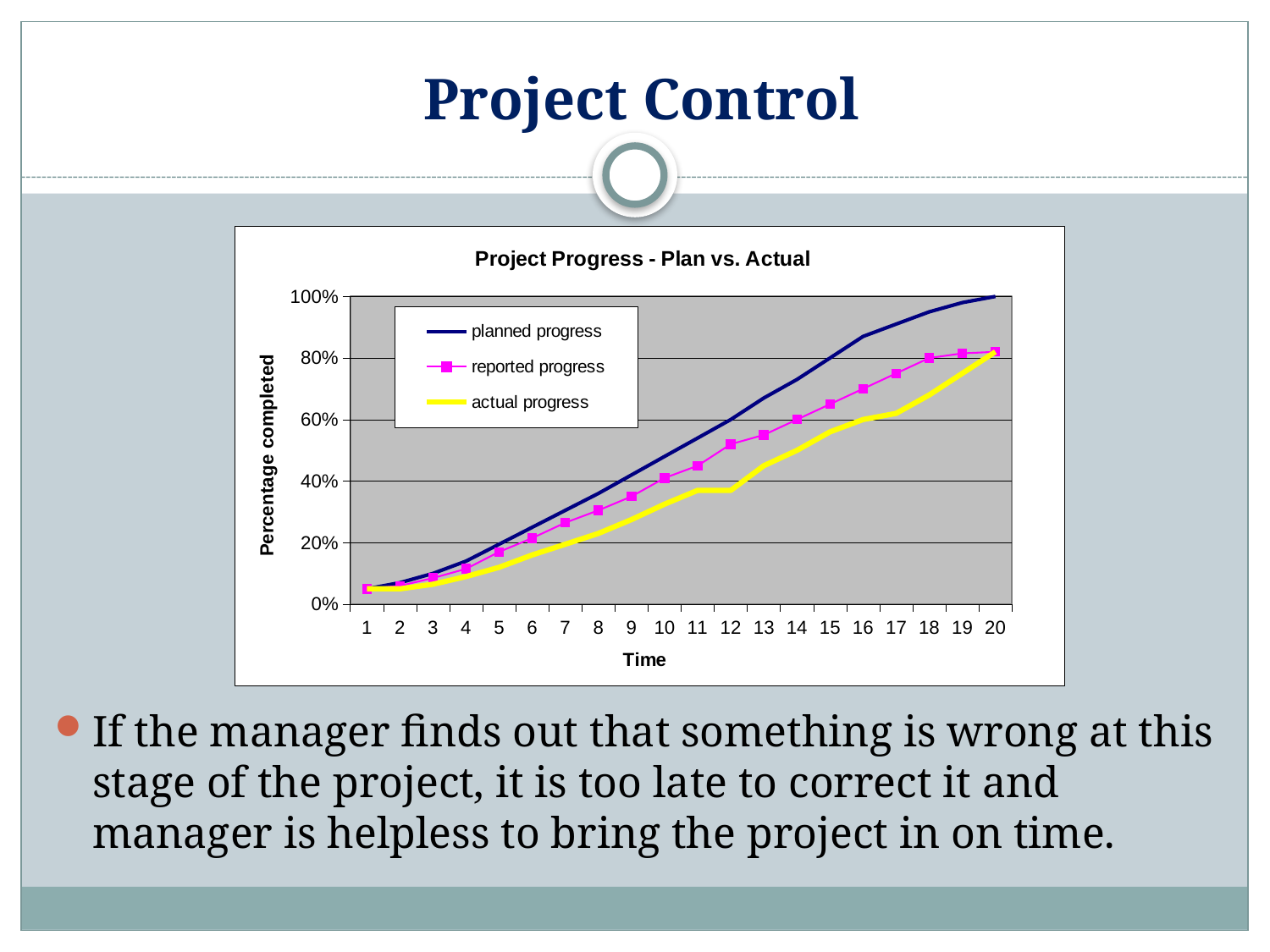
Is the value for reported progress at time 5 greater or less than 20%? less Is the value for planned progress at time 8 greater or less than 40%? less Which series has the highest value at time 14? planned progress What is the title of the chart? Project Progress - Plan vs. Actual How many series does the legend list? 3 How many time points are shown on the x axis? 20 At time 16, which is larger: planned progress or actual progress? planned progress Is the value for planned progress at time 16 greater or less than 80%? greater What is the value of planned progress at time 20? 100% What kind of chart is shown on the slide? line chart Does planned progress rise or fall as time increases from 1 to 20? rise